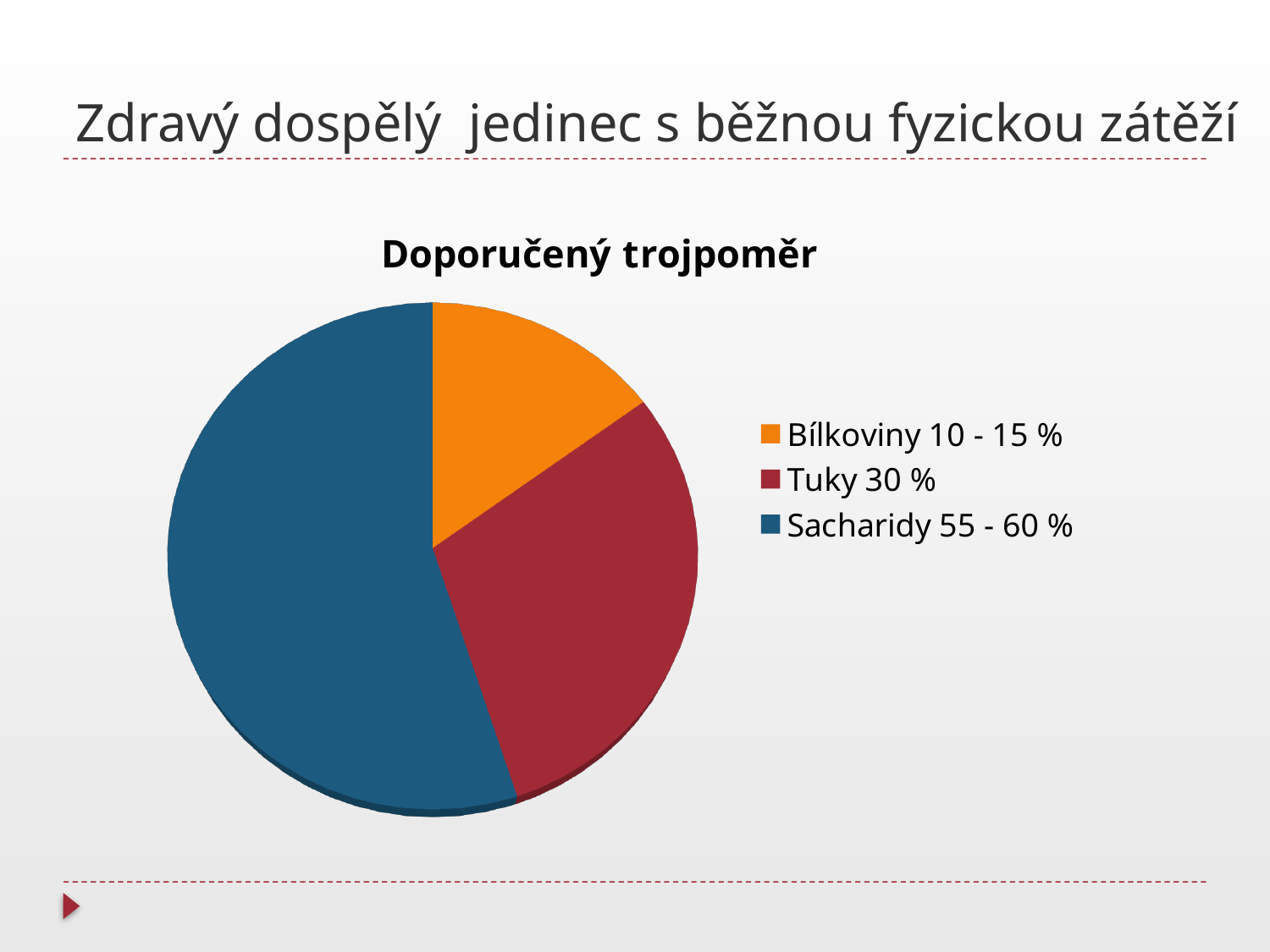
What share of the pie is given for Tuky in the legend? 30 % What kind of chart is shown on the slide? pie chart Which slice is larger, Sacharidy or Tuky? Sacharidy What range is given for Sacharidy in the legend? 55 - 60 % Which slice is larger, Tuky or Bílkoviny? Tuky What colour is the Sacharidy slice? blue How many slices does the pie chart have? 3 What range is given for Bílkoviny in the legend? 10 - 15 % Which category has the largest slice of the pie? Sacharidy 55 - 60 % What is the title of the chart? Doporučený trojpoměr Which category has the smallest slice of the pie? Bílkoviny 10 - 15 %